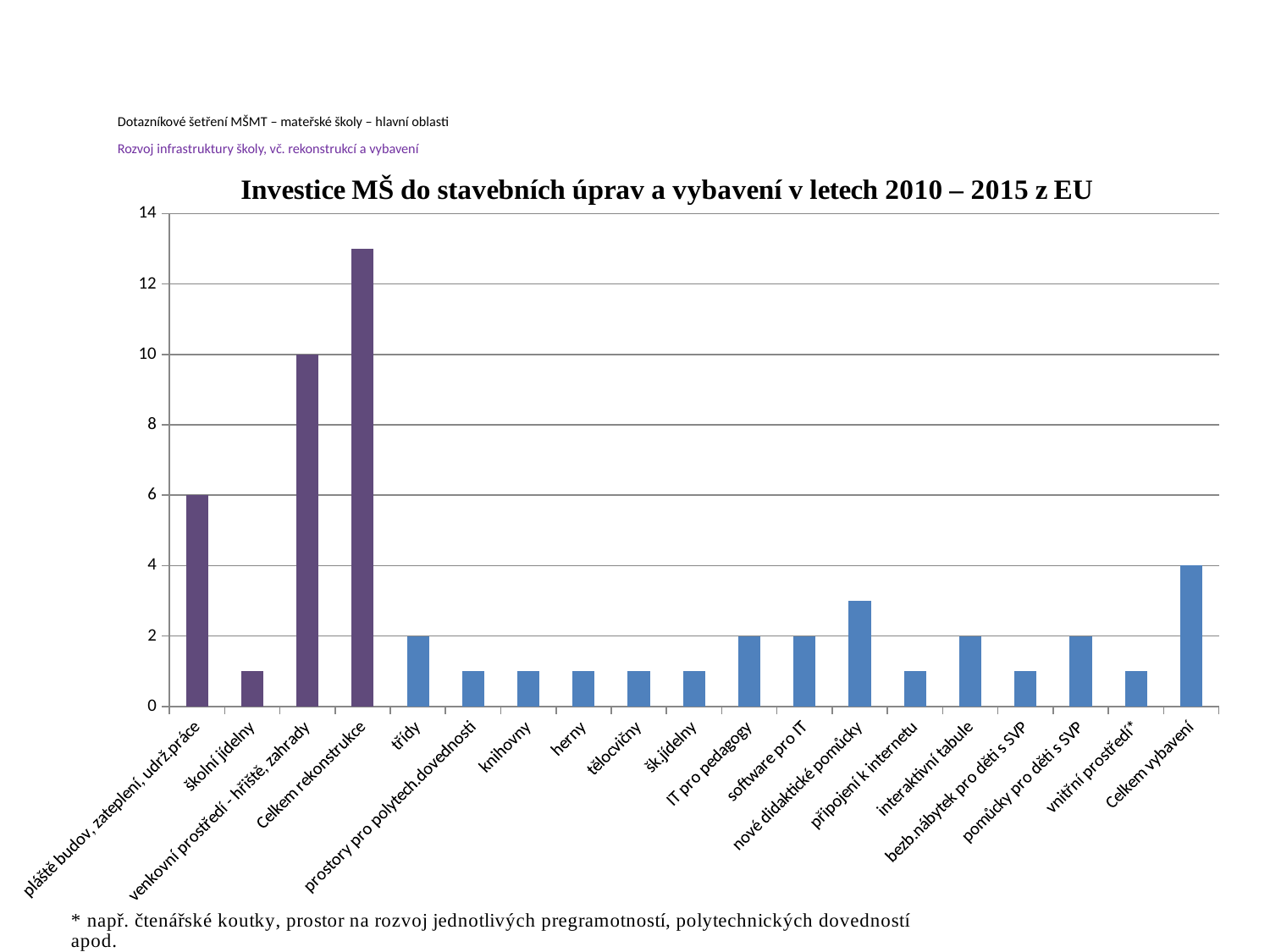
What is the value for 'venkovní prostředí - hřiště, zahrady'? 10 Which category has the highest value? Celkem rekonstrukce What is the value for 'Celkem vybavení'? 4 What is the difference between the values for 'venkovní prostředí - hřiště, zahrady' and 'pláště budov, zateplení, udrž.práce'? 4 What kind of chart is shown on the slide? bar chart Which is larger, the value for 'Celkem rekonstrukce' or the value for 'Celkem vybavení'? Celkem rekonstrukce Is the value for 'Celkem rekonstrukce' greater or less than 12? greater What is the value for 'pláště budov, zateplení, udrž.práce'? 6 How many categories are shown on the x axis? 19 Is the value for 'nové didaktické pomůcky' greater or less than 2? greater What is the value for 'třídy'? 2 Is the value for 'školní jídelny' greater or less than 2? less